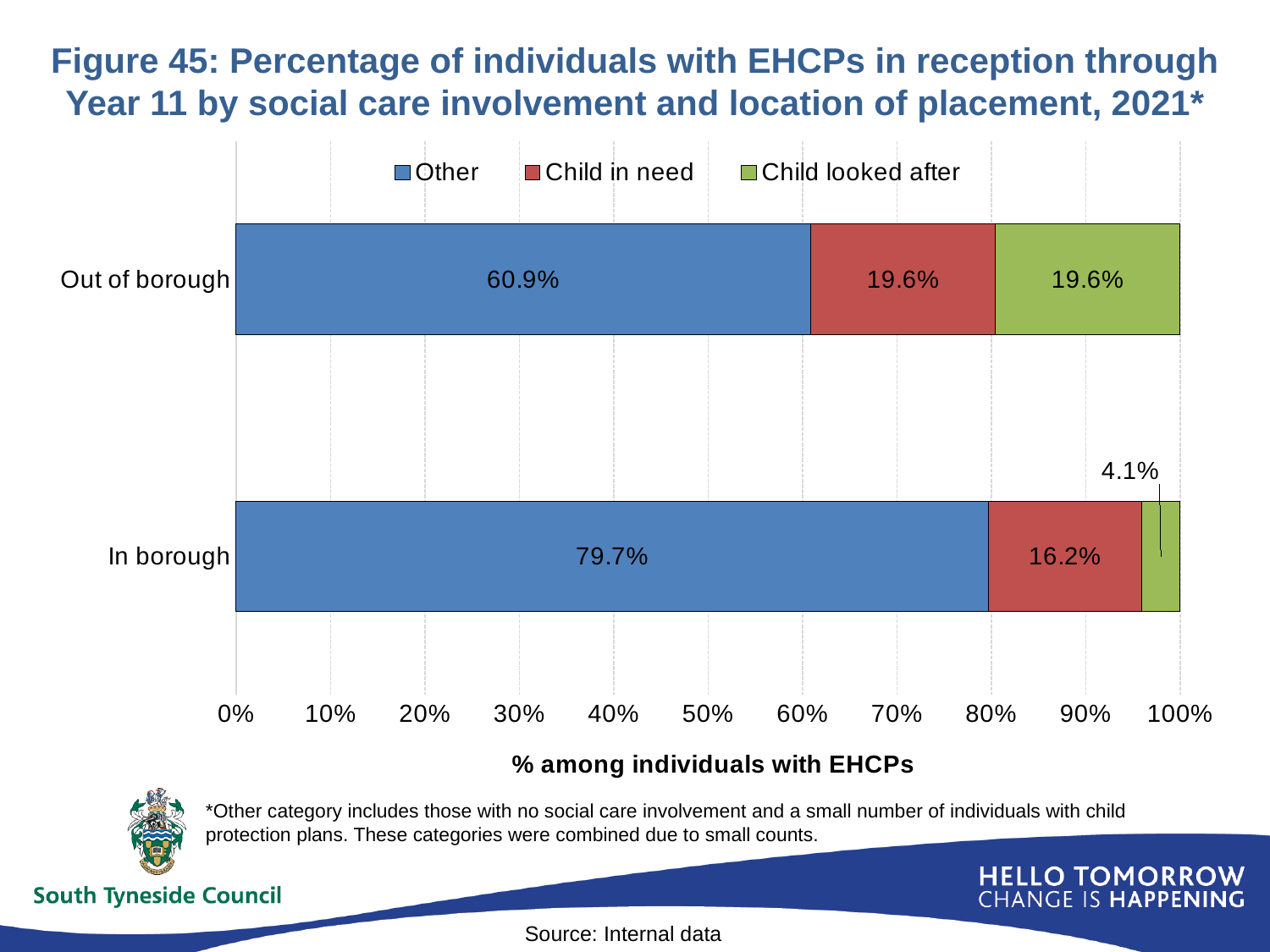
What is the Child in need percentage for the In borough category? 16.2% What percentage of individuals with EHCPs placed in borough are in the Other category? 79.7% What percentage of individuals with EHCPs placed out of borough are in the Other category? 60.9% What kind of chart is shown on the slide? Stacked bar chart What is the Child looked after percentage for the In borough category? 4.1% How many series does the legend list? 3 Which location of placement has the higher Other percentage? In borough What is the Child looked after percentage for the Out of borough category? 19.6% What is the difference between the Other percentage for In borough and for Out of borough? 18.8% How many location categories are shown on the chart? 2 Which location of placement has the higher Child looked after percentage? Out of borough What is the difference between the Child looked after percentage for Out of borough and for In borough? 15.5%